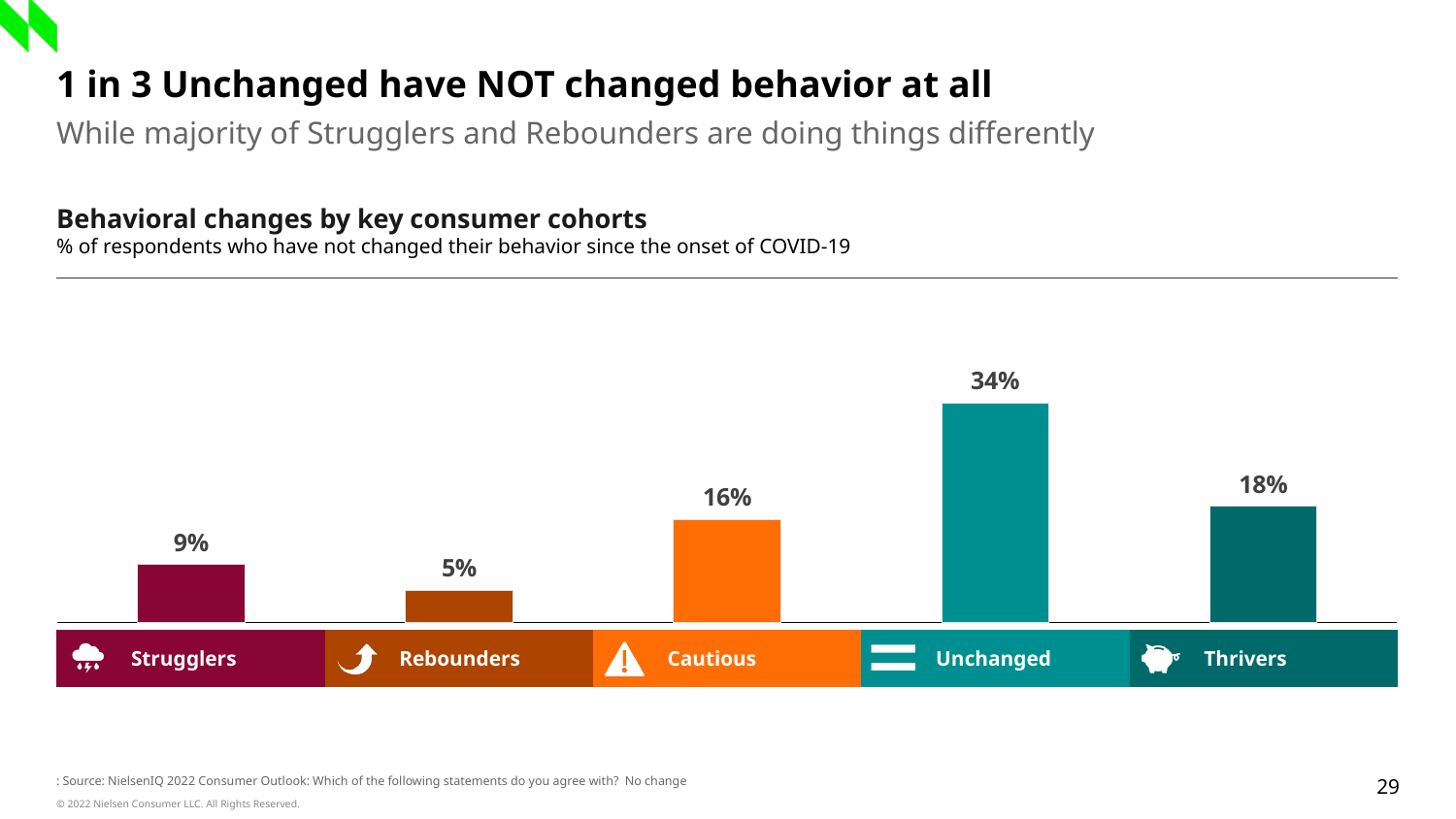
Which cohort has a larger value, Cautious or Thrivers? Thrivers What is the title of the chart? Behavioral changes by key consumer cohorts What is the difference between the values for Unchanged and Thrivers? 16% What is the difference between the values for Strugglers and Rebounders? 4% What is the value shown for the Rebounders cohort? 5% What percentage of Strugglers have not changed their behavior since the onset of COVID-19? 9% Which consumer cohort has the lowest share of respondents who have not changed their behavior? Rebounders What is the value shown for the Cautious cohort? 16% Which consumer cohort has the highest share of respondents who have not changed their behavior? Unchanged What is the value shown for the Unchanged cohort? 34% What kind of chart is used on this slide? Bar chart How many consumer cohorts are shown in the chart? 5